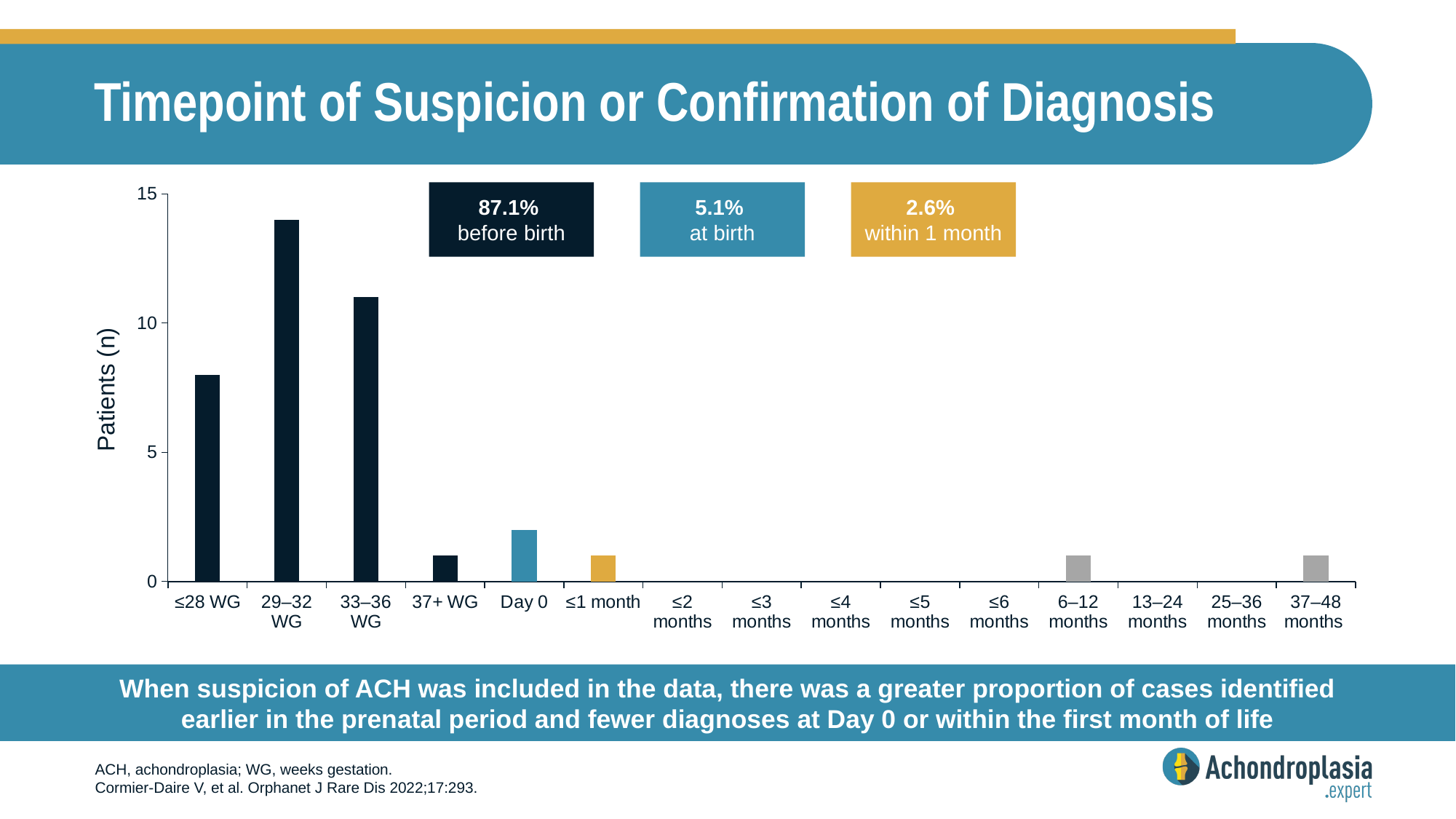
Is the value for 29–32 WG greater or less than 10? greater Is the value for ≤28 WG greater or less than 10? less Which timepoint category has the highest number of patients? 29–32 WG How many timepoint categories are shown on the x axis? 15 Which has more patients, ≤28 WG or 33–36 WG? 33–36 WG Is the value for 33–36 WG greater or less than 10? greater Which has more patients, 29–32 WG or ≤28 WG? 29–32 WG What is the label on the y axis? Patients (n) What kind of chart is shown on the slide? bar chart Do the values rise or fall from 29–32 WG to 37+ WG? fall What percentage of cases were identified before birth, according to the label on the chart? 87.1%